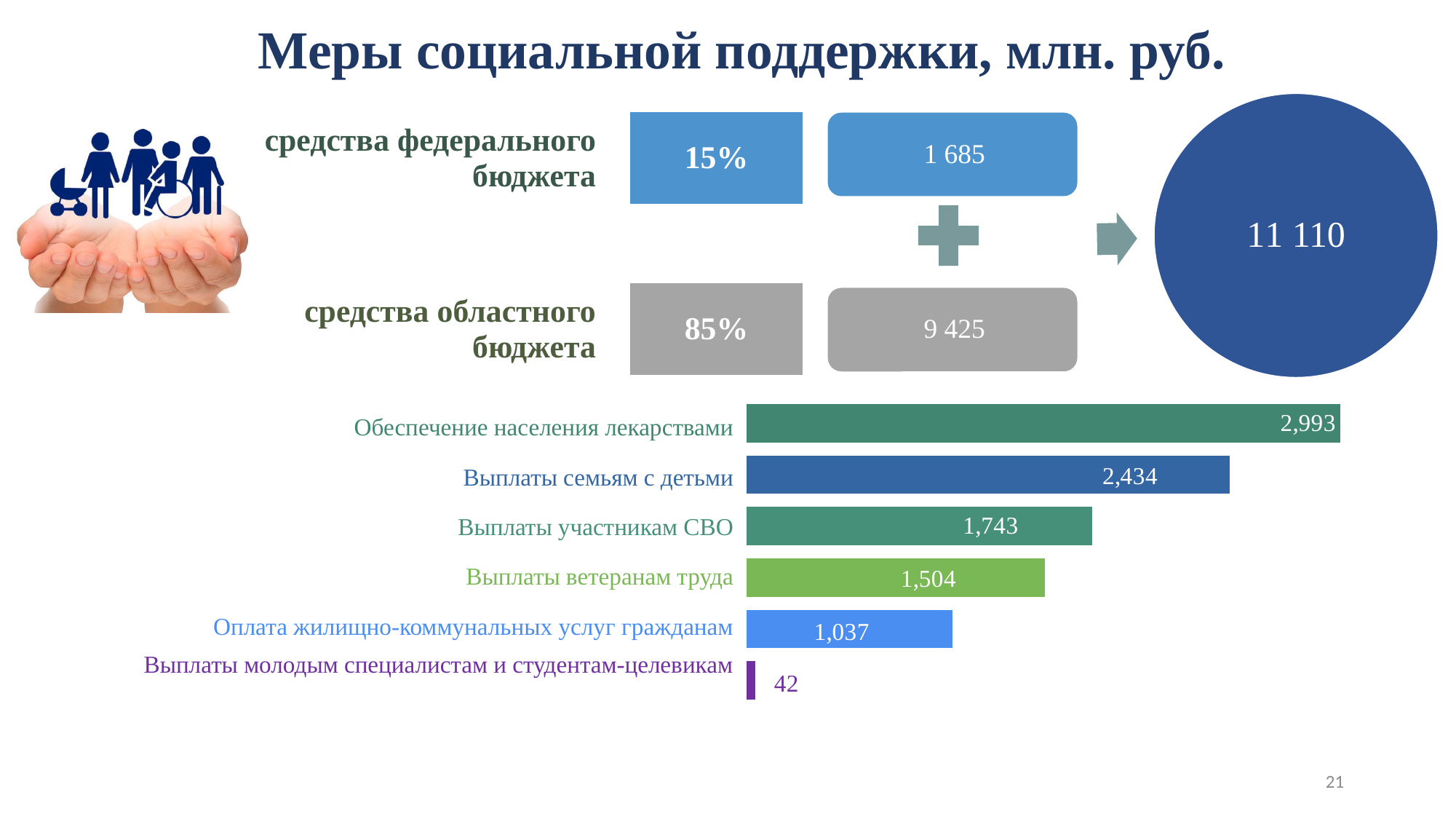
In the bar chart, what is the value for Обеспечение населения лекарствами? 2,993 In the bar chart, what is the value for Оплата жилищно-коммунальных услуг гражданам? 1,037 Which category in the bar chart has the highest value? Обеспечение населения лекарствами What is the title of the slide containing the bar chart? Меры социальной поддержки, млн. руб. How many categories does the bar chart show? 6 What type of chart is shown at the bottom of the slide? bar chart In the bar chart, what is the difference between Выплаты ветеранам труда and Оплата жилищно-коммунальных услуг гражданам? 467 In the bar chart, what is the difference between Обеспечение населения лекарствами and Выплаты семьям с детьми? 559 In the bar chart, which is larger: Выплаты семьям с детьми or Выплаты участникам СВО? Выплаты семьям с детьми Which category in the bar chart has the lowest value? Выплаты молодым специалистам и студентам-целевикам In the bar chart, what is the value for Выплаты молодым специалистам и студентам-целевикам? 42 In the bar chart, what is the value for Выплаты участникам СВО? 1,743